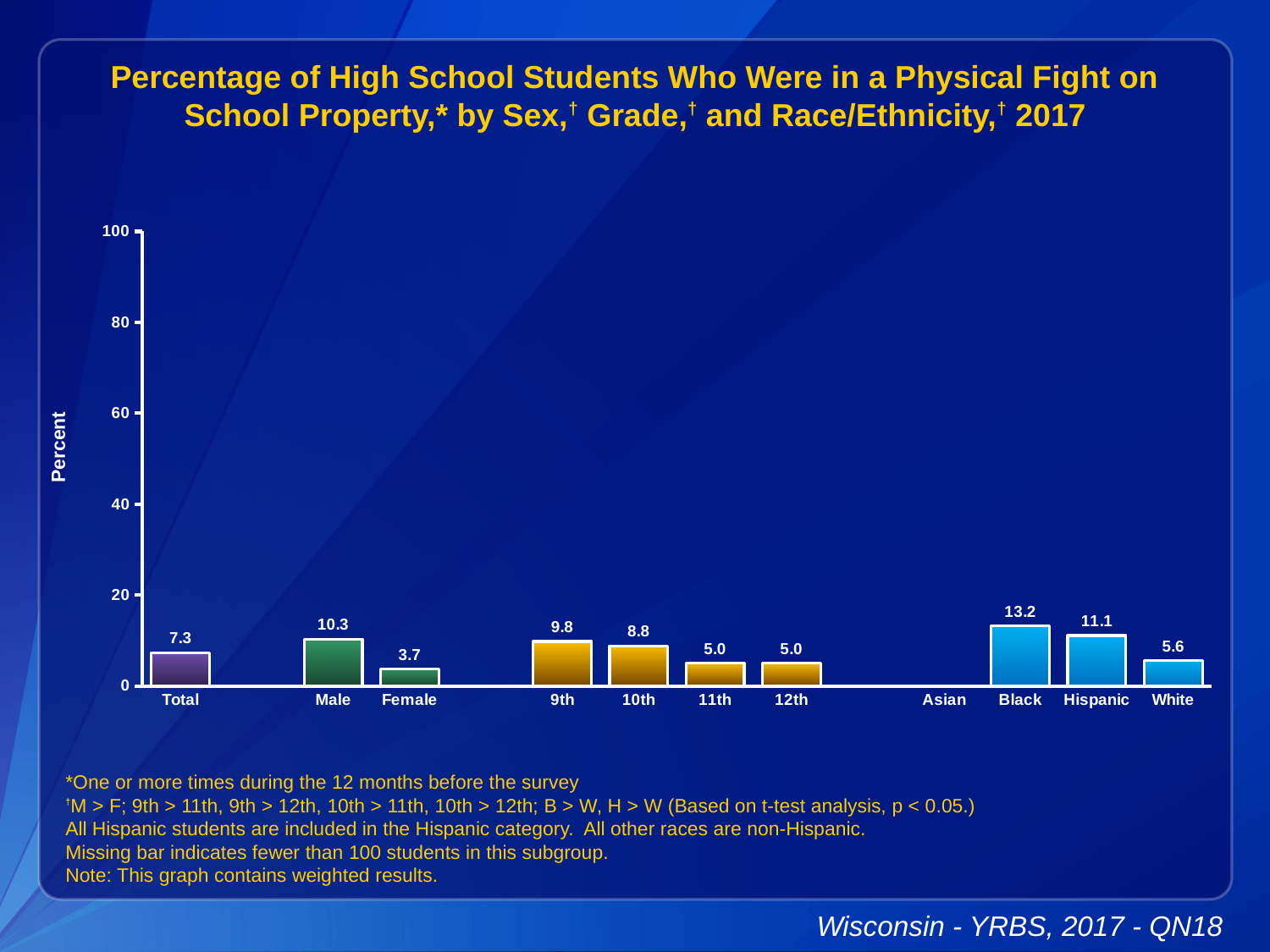
What is the value for Female? 3.7 What is the value for Total? 7.3 What kind of chart is this? bar chart What is the value for Black? 13.2 Which category has the lowest value among those with a bar shown? Female Is the value for Hispanic greater or less than 20? less What is the value for Male? 10.3 What is the difference between the values for Male and Female? 6.6 How many categories are labeled on the x axis? 11 Which is larger, the value for 9th or the value for 10th? 9th Which category has the highest value? Black Which category has no bar shown? Asian